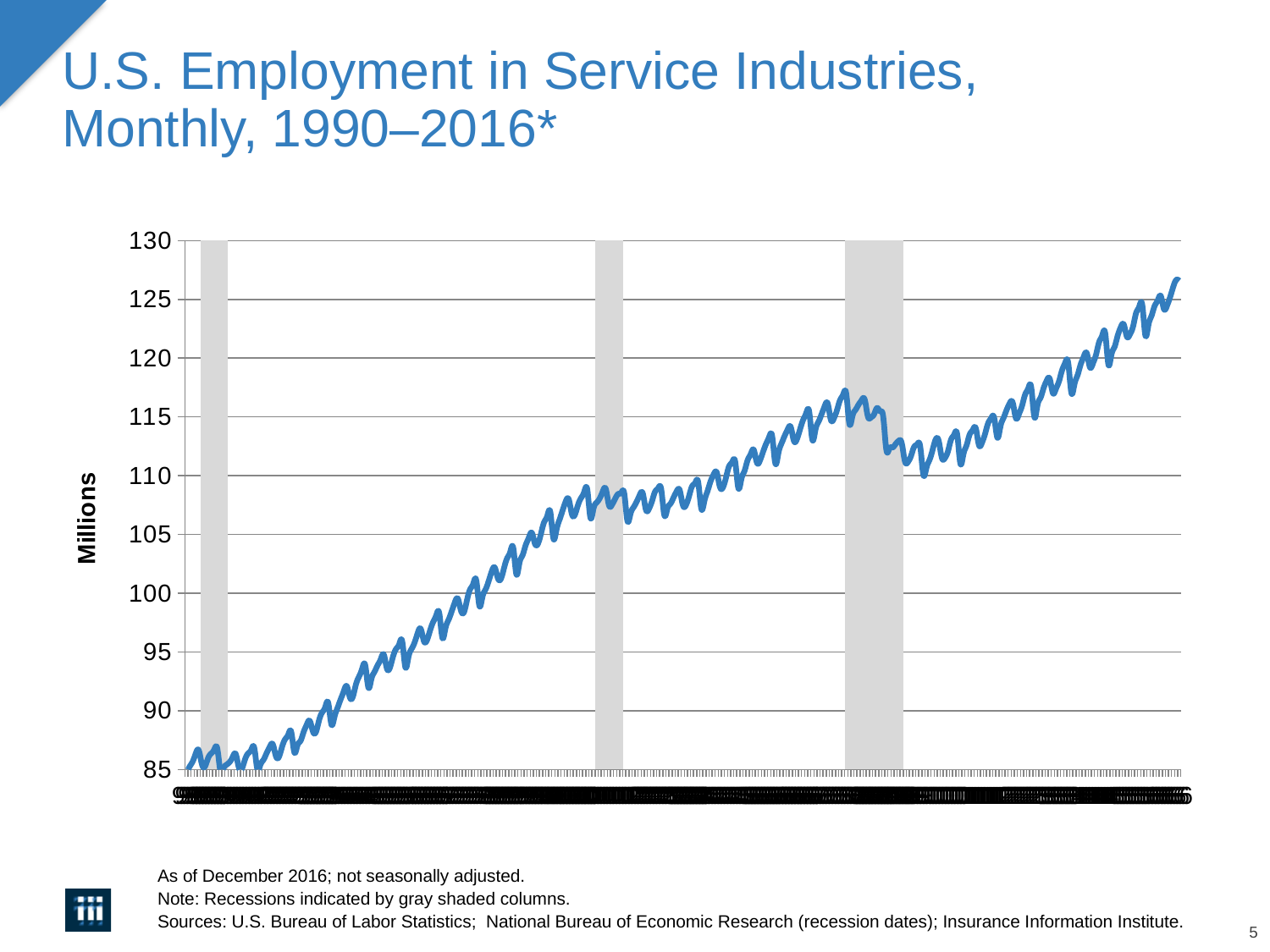
What is the label on the vertical axis? Millions Is the value at the far left start of the line (1990) greater or less than 90? less Is the value at the far right end of the line (end of 2016) greater or less than 125? greater What is the title of the chart? U.S. Employment in Service Industries, Monthly, 1990–2016* Is the lowest value reached just after the third gray shaded recession column greater or less than 115? less Overall, do the values rise or fall from left to right along the x axis? rise Is the value at the far right end of the line greater or less than the value at the far left start of the line? greater What is the highest value shown on the vertical axis? 130 How many gray shaded recession columns are shown on the chart? 3 What kind of chart is shown on the slide? line chart